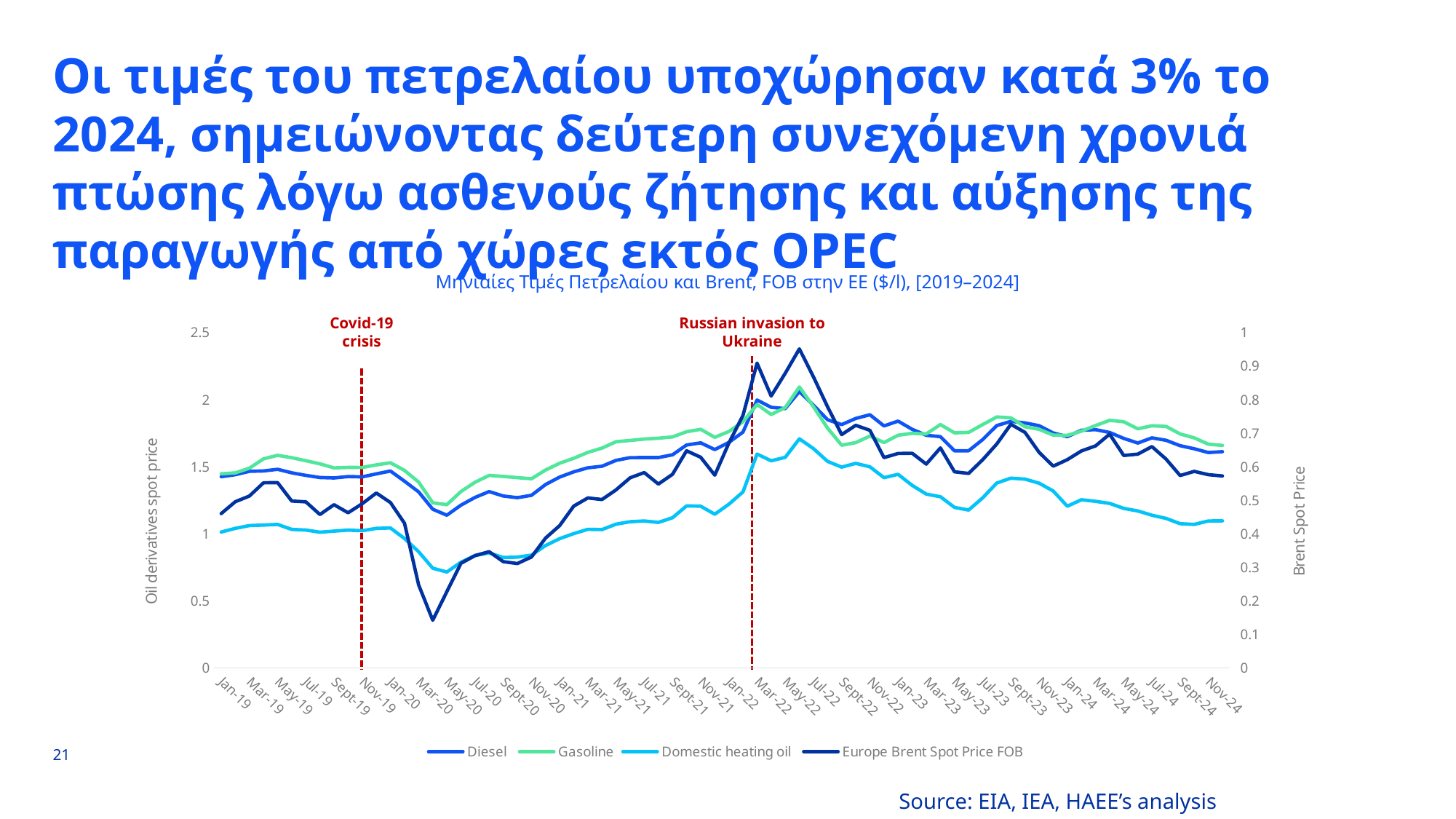
Is the peak value of Gasoline in 2022 greater or less than 2? greater What kind of chart is shown on the slide? Line chart What two events are marked with red dashed vertical lines on the chart? Covid-19 crisis and Russian invasion to Ukraine Which is higher in May-19, Gasoline or Diesel? Gasoline Does the Domestic heating oil series rise or fall from Jul-22 to Nov-24? Fall Is the value for Gasoline in Jan-19 greater or less than 1? greater Which series are listed in the chart legend? Diesel, Gasoline, Domestic heating oil, Europe Brent Spot Price FOB Which of the oil derivative series (left axis) is lowest in Nov-24? Domestic heating oil Is the value for Domestic heating oil in Nov-24 greater or less than 1.5? less How many series does the legend list? 4